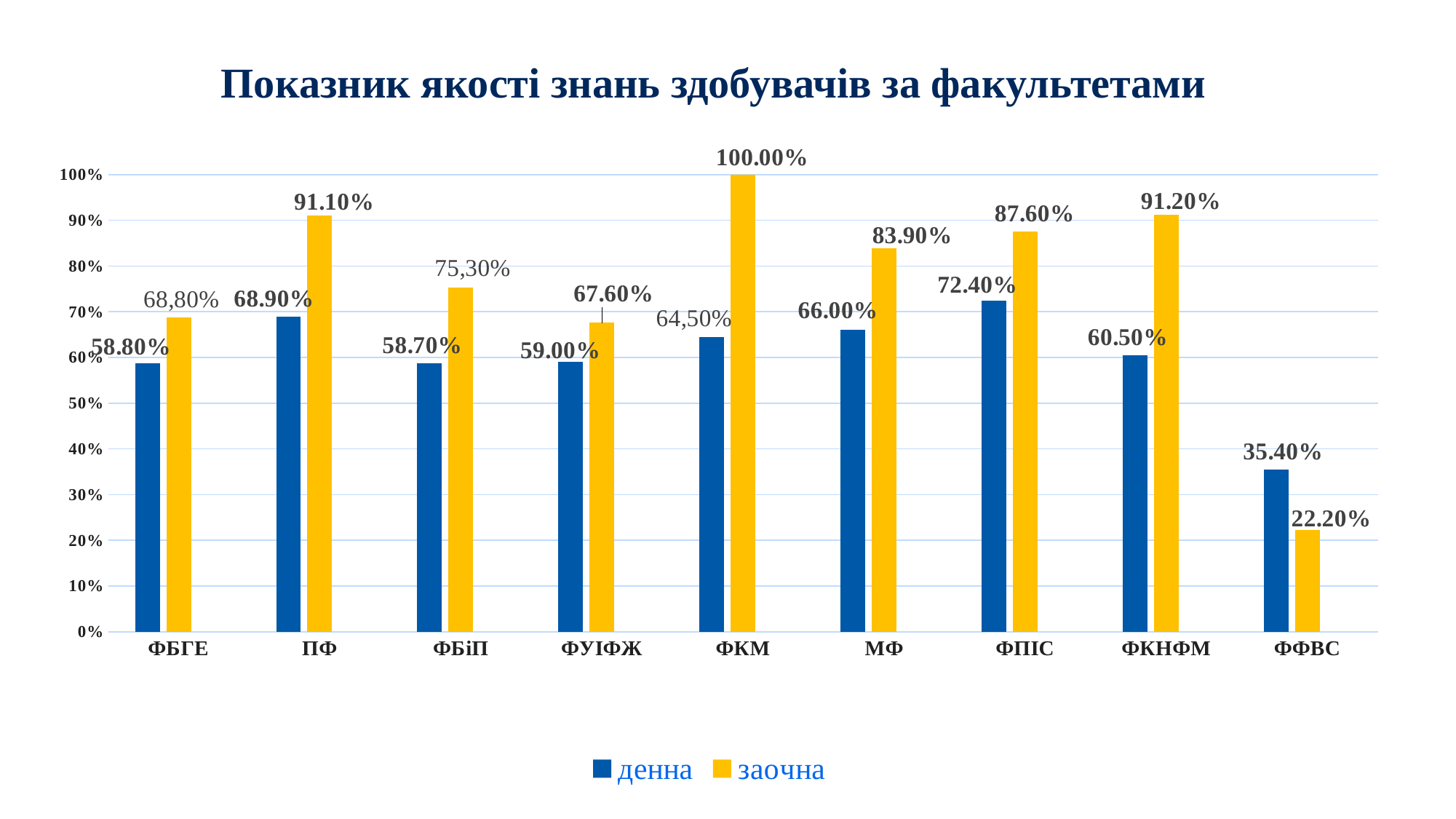
What is the difference between the денна and заочна values at ФФВС? 13.20% What is the value for заочна at ФКНФМ? 91.20% Which faculty has the highest заочна value? ФКМ What is the value for денна at ФКМ? 64,50% What is the value for заочна at ФБіП? 75,30% Which is larger at ПФ: the денна value or the заочна value? заочна Which faculty has the lowest денна value? ФФВС How many series does the legend list? 2 How many faculties are shown on the x axis? 9 What kind of chart is shown on the slide? bar chart What is the value for денна at ФПІС? 72.40% What is the title of the chart? Показник якості знань здобувачів за факультетами